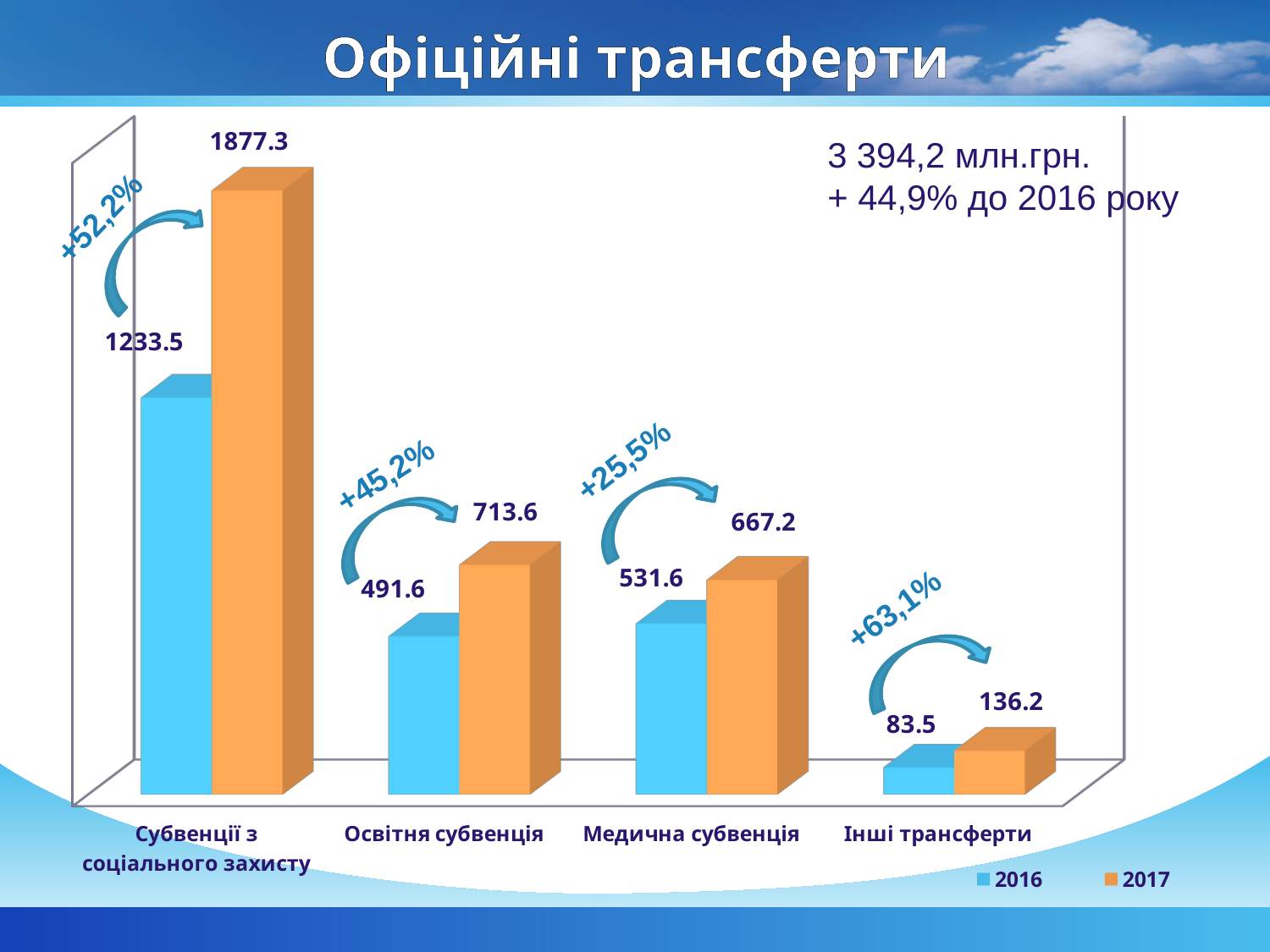
What is the 2017 value for Інші трансферти? 136.2 How many categories are shown on the x axis? 4 Which is larger in 2016: Освітня субвенція or Медична субвенція? Медична субвенція What is the 2016 value for Медична субвенція? 531.6 How many series does the legend list? 2 Which category has the highest 2017 value? Субвенції з соціального захисту What is the 2017 value for Субвенції з соціального захисту? 1877.3 What is the 2016 value for Освітня субвенція? 491.6 What is the difference between the 2017 and 2016 values for Субвенції з соціального захисту? 643.8 What is the difference between the 2017 and 2016 values for Інші трансферти? 52.7 What kind of chart is shown on the slide? Bar chart Which category has the lowest 2016 value? Інші трансферти